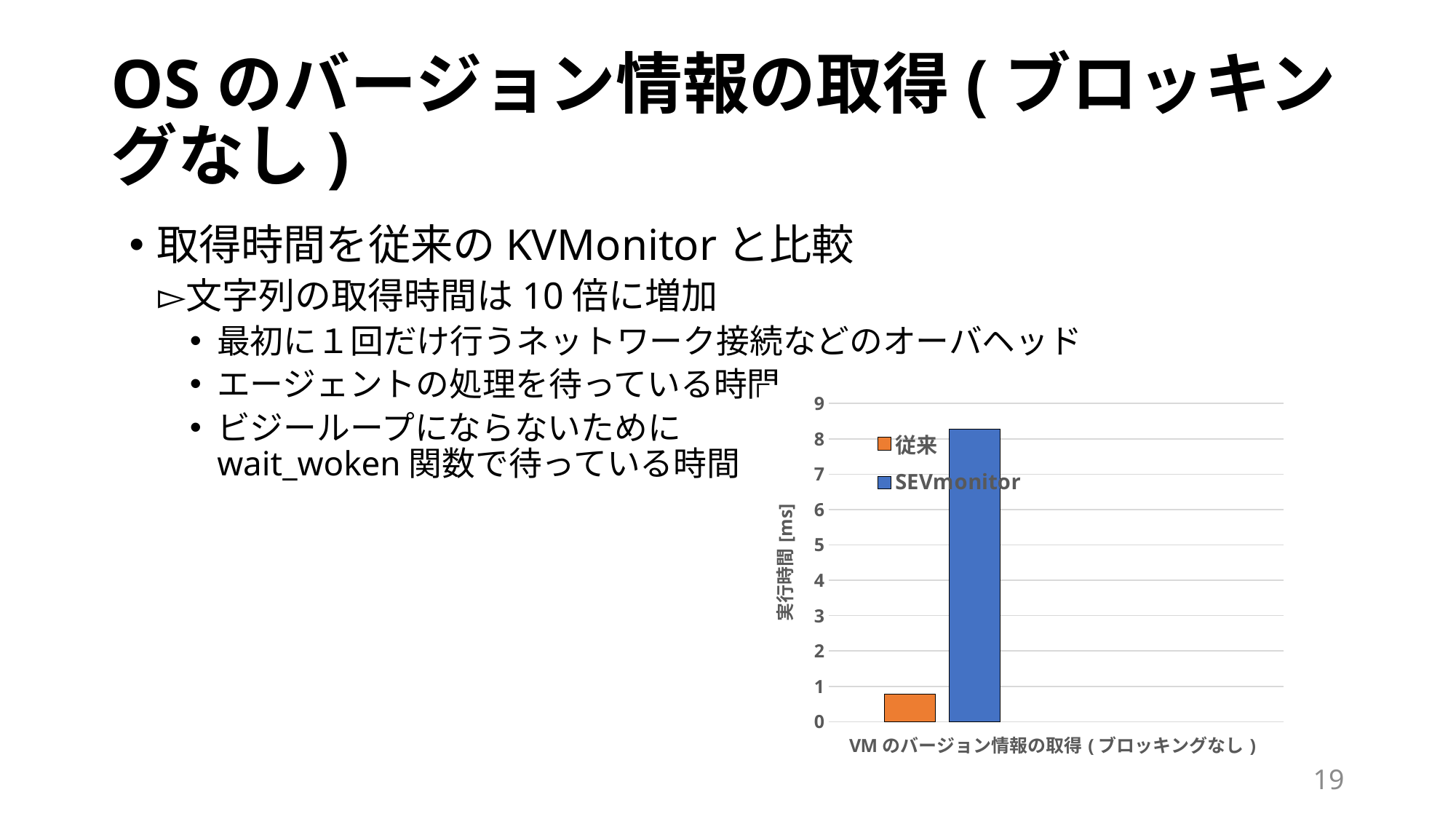
How many series does the chart's legend list? 2 What is the label of the y axis of the chart? 実行時間 [ms] Is the value for SEVmonitor greater or less than 5? greater What kind of chart is shown on the slide? bar chart Is the value for SEVmonitor greater or less than 7? greater Which series has the highest bar in the chart? SEVmonitor How many categories are plotted on the x axis of the chart? 1 Which colour represents the SEVmonitor series in the chart? blue Which series has the lowest bar in the chart? 従来 Which series has the higher bar in the chart, 従来 or SEVmonitor? SEVmonitor Is the value for 従来 greater or less than 1? less